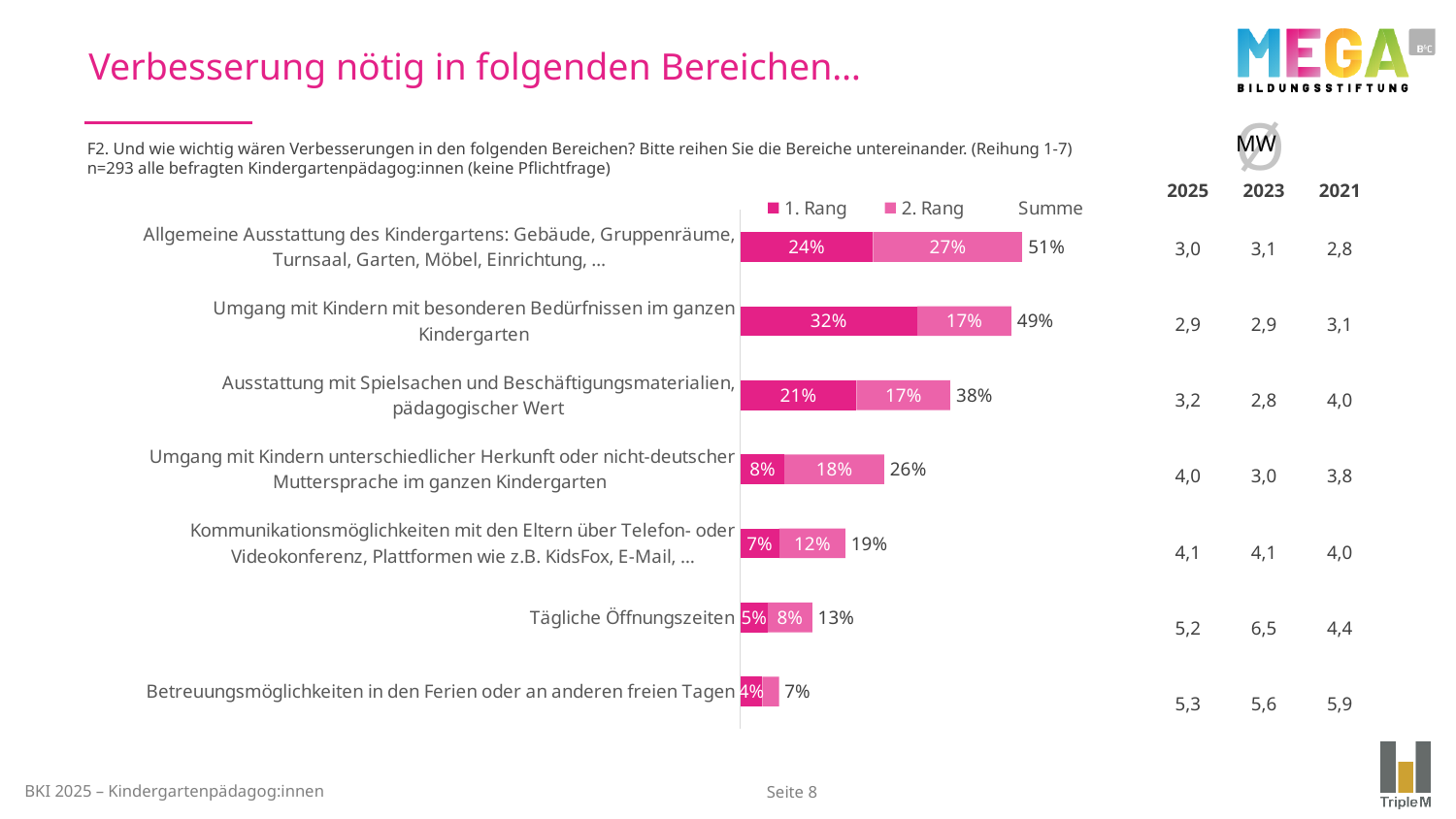
What is the total (Summe) of the stacked bar for "Tägliche Öffnungszeiten"? 13% Which category has the highest Summe value? Allgemeine Ausstattung des Kindergartens: Gebäude, Gruppenräume, Turnsaal, Garten, Möbel, Einrichtung, … What is the difference between the Summe for "Allgemeine Ausstattung des Kindergartens" and the Summe for "Umgang mit Kindern mit besonderen Bedürfnissen"? 2 percentage points Which category has the highest 1. Rang value? Umgang mit Kindern mit besonderen Bedürfnissen im ganzen Kindergarten What is the 1. Rang value for "Umgang mit Kindern mit besonderen Bedürfnissen im ganzen Kindergarten"? 32% What kind of chart is shown on the slide? Stacked bar chart How many categories (areas) are plotted in the chart? 7 What is the 2. Rang value for "Allgemeine Ausstattung des Kindergartens"? 27% Which is larger for "Umgang mit Kindern unterschiedlicher Herkunft oder nicht-deutscher Muttersprache": the 1. Rang value or the 2. Rang value? 2. Rang What is the Summe for "Ausstattung mit Spielsachen und Beschäftigungsmaterialien, pädagogischer Wert"? 38% Which category has the lowest Summe value? Betreuungsmöglichkeiten in den Ferien oder an anderen freien Tagen How many series does the chart legend list? 3